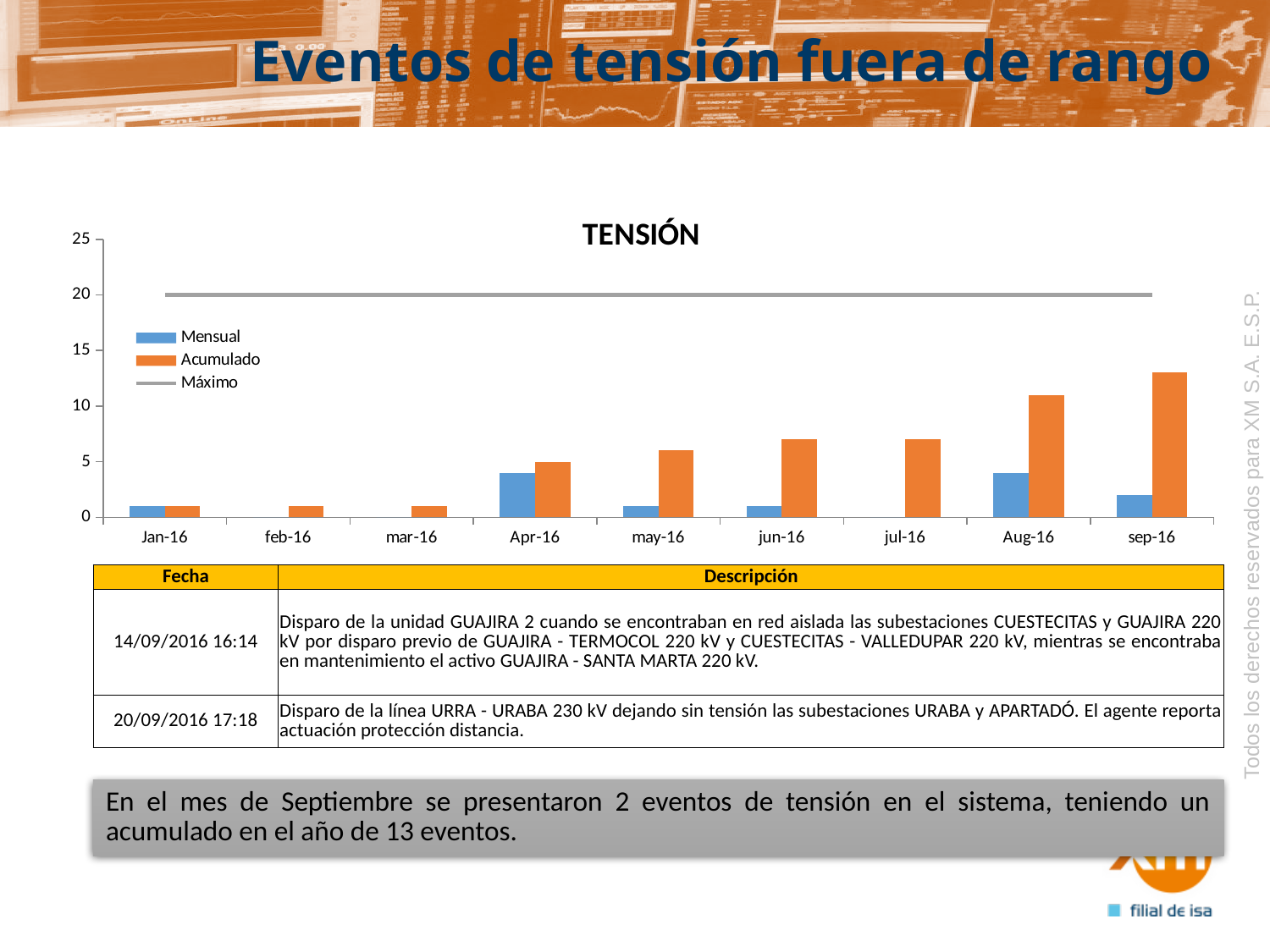
How many series does the legend of the TENSIÓN chart list? 3 Does the Acumulado series rise or fall from Jan-16 to sep-16 in the TENSIÓN chart? rise What is the Acumulado value for sep-16 in the TENSIÓN chart? 13 Which is larger in the TENSIÓN chart: the Acumulado value for Aug-16 or for Apr-16? Aug-16 How many months are shown on the x axis of the TENSIÓN chart? 9 Is the Acumulado value for jun-16 greater or less than 10? less Is the Acumulado value for Aug-16 greater or less than 10? greater At what level is the Máximo line drawn in the TENSIÓN chart? 20 What kind of chart is the TENSIÓN chart? bar chart What is the Mensual value for sep-16 in the TENSIÓN chart? 2 In which month is the Acumulado bar highest in the TENSIÓN chart? sep-16 What is the title of the chart on the slide? TENSIÓN